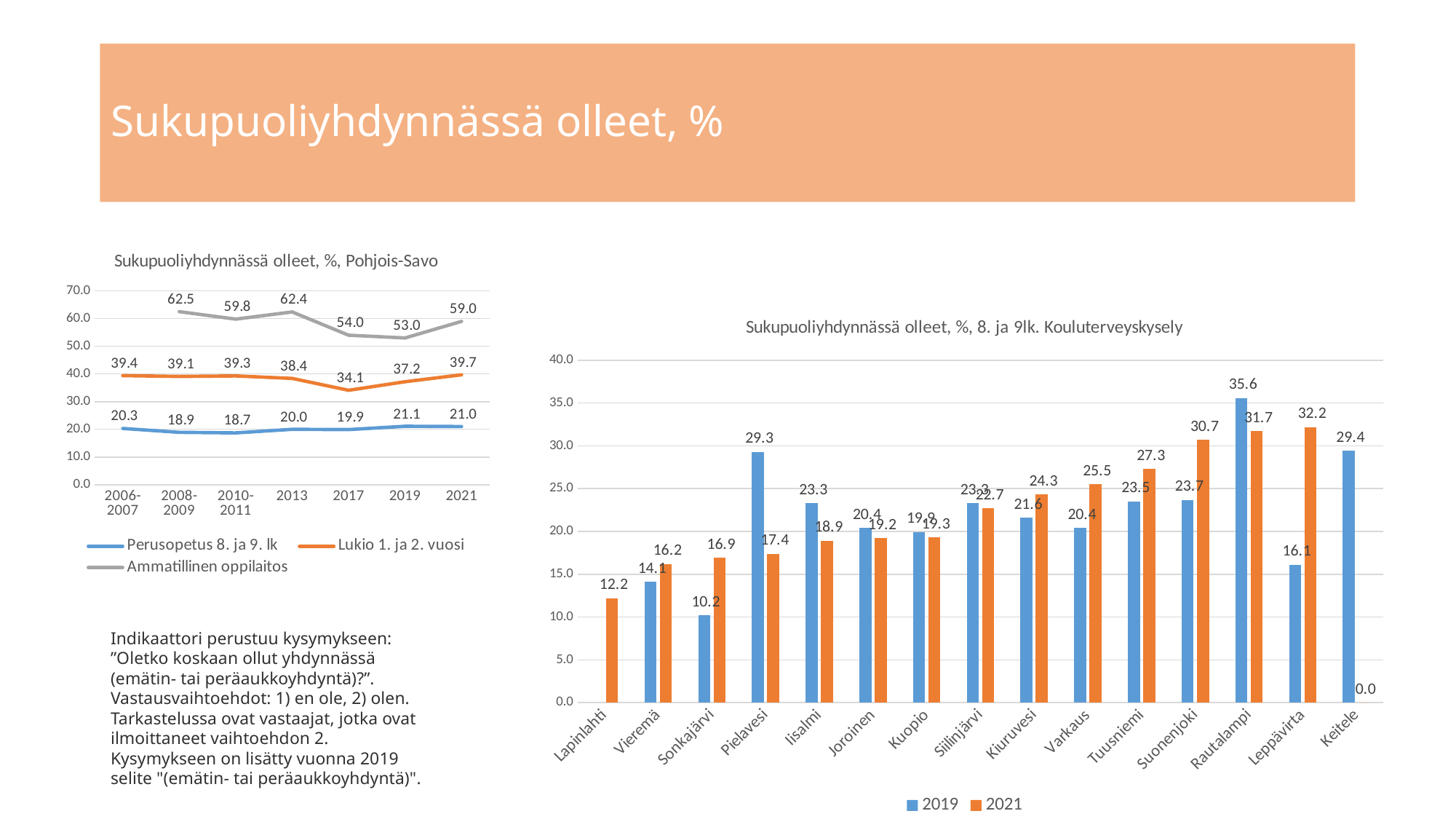
In the chart titled "Sukupuoliyhdynnässä olleet, %, 8. ja 9lk. Kouluterveyskysely", how many municipalities are shown on the x axis? 15 In the chart titled "Sukupuoliyhdynnässä olleet, %, Pohjois-Savo", what is the value for Lukio 1. ja 2. vuosi in 2017? 34.1 In the chart titled "Sukupuoliyhdynnässä olleet, %, 8. ja 9lk. Kouluterveyskysely", which is larger for Pielavesi, the 2019 value or the 2021 value? 2019 In the chart titled "Sukupuoliyhdynnässä olleet, %, Pohjois-Savo", in which period is the Ammatillinen oppilaitos value lowest? 2019 In the chart titled "Sukupuoliyhdynnässä olleet, %, 8. ja 9lk. Kouluterveyskysely", what is the 2021 value for Leppävirta? 32.2 In the chart titled "Sukupuoliyhdynnässä olleet, %, Pohjois-Savo", how many series does the legend list? 3 In the chart titled "Sukupuoliyhdynnässä olleet, %, Pohjois-Savo", what kind of chart is it? Line chart In the chart titled "Sukupuoliyhdynnässä olleet, %, Pohjois-Savo", what is the value for Ammatillinen oppilaitos in 2021? 59.0 In the chart titled "Sukupuoliyhdynnässä olleet, %, 8. ja 9lk. Kouluterveyskysely", what is the difference between the 2021 and 2019 values for Suonenjoki? 7.0 In the chart titled "Sukupuoliyhdynnässä olleet, %, 8. ja 9lk. Kouluterveyskysely", which municipality has the lowest 2019 value among those with a 2019 bar? Sonkajärvi In the chart titled "Sukupuoliyhdynnässä olleet, %, Pohjois-Savo", what is the difference between the Ammatillinen oppilaitos value and the Perusopetus 8. ja 9. lk value in 2019? 31.9 In the chart titled "Sukupuoliyhdynnässä olleet, %, 8. ja 9lk. Kouluterveyskysely", which municipality has the highest 2019 value? Rautalampi